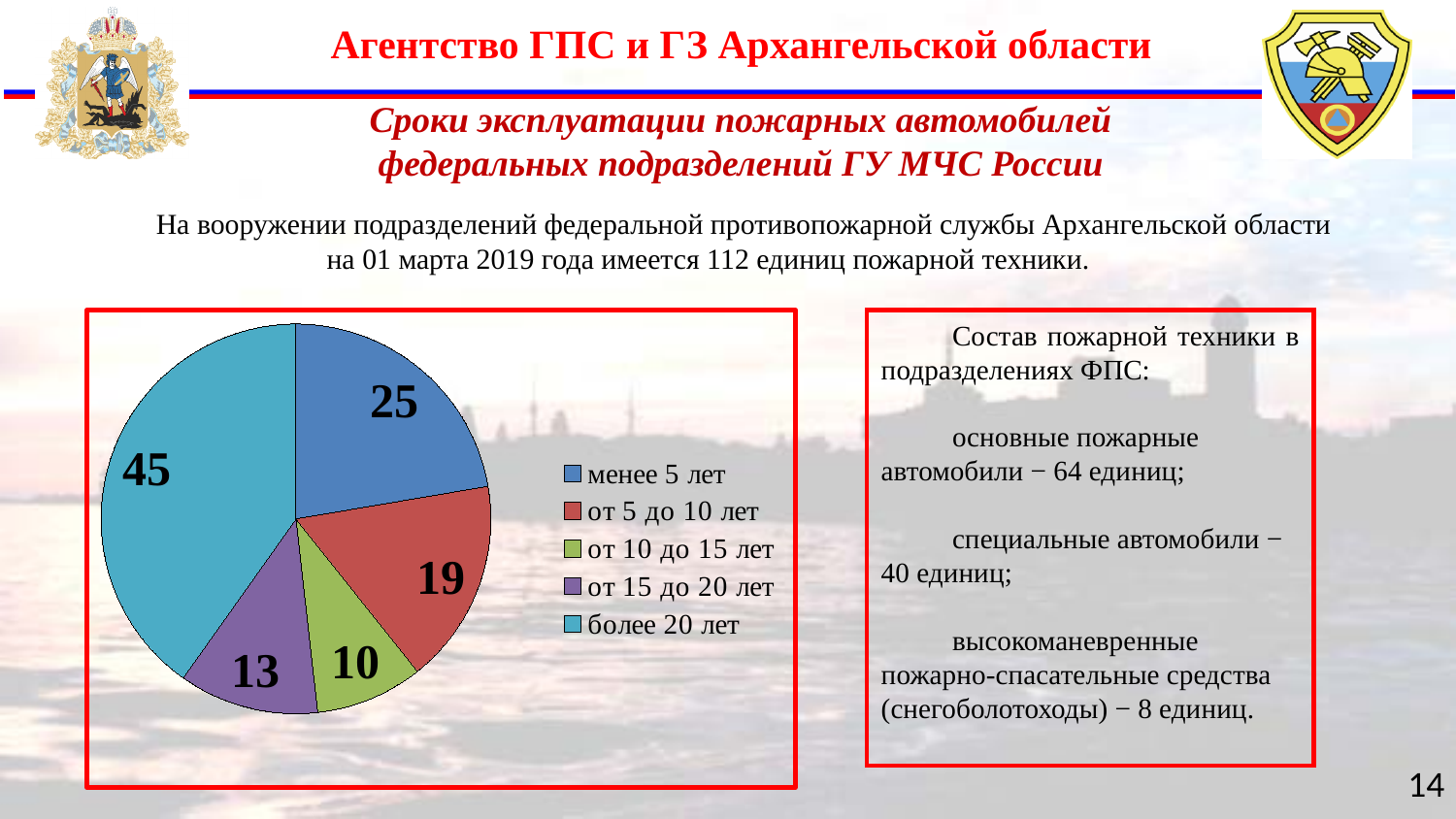
Which category has the largest slice of the pie? более 20 лет What is the value for the slice 'более 20 лет'? 45 What colour is the slice for 'более 20 лет'? light blue (cyan) How many categories does the pie chart have? 5 What is the value for the slice 'от 10 до 15 лет'? 10 Which category has the smallest slice of the pie? от 10 до 15 лет Which is larger: the value for 'от 5 до 10 лет' or the value for 'от 15 до 20 лет'? от 5 до 10 лет What is the value for the slice 'от 5 до 10 лет'? 19 What is the value for the slice 'от 15 до 20 лет'? 13 What type of chart is shown on the slide? pie chart What is the difference between the values for 'более 20 лет' and 'менее 5 лет'? 20 What is the value for the slice 'менее 5 лет'? 25